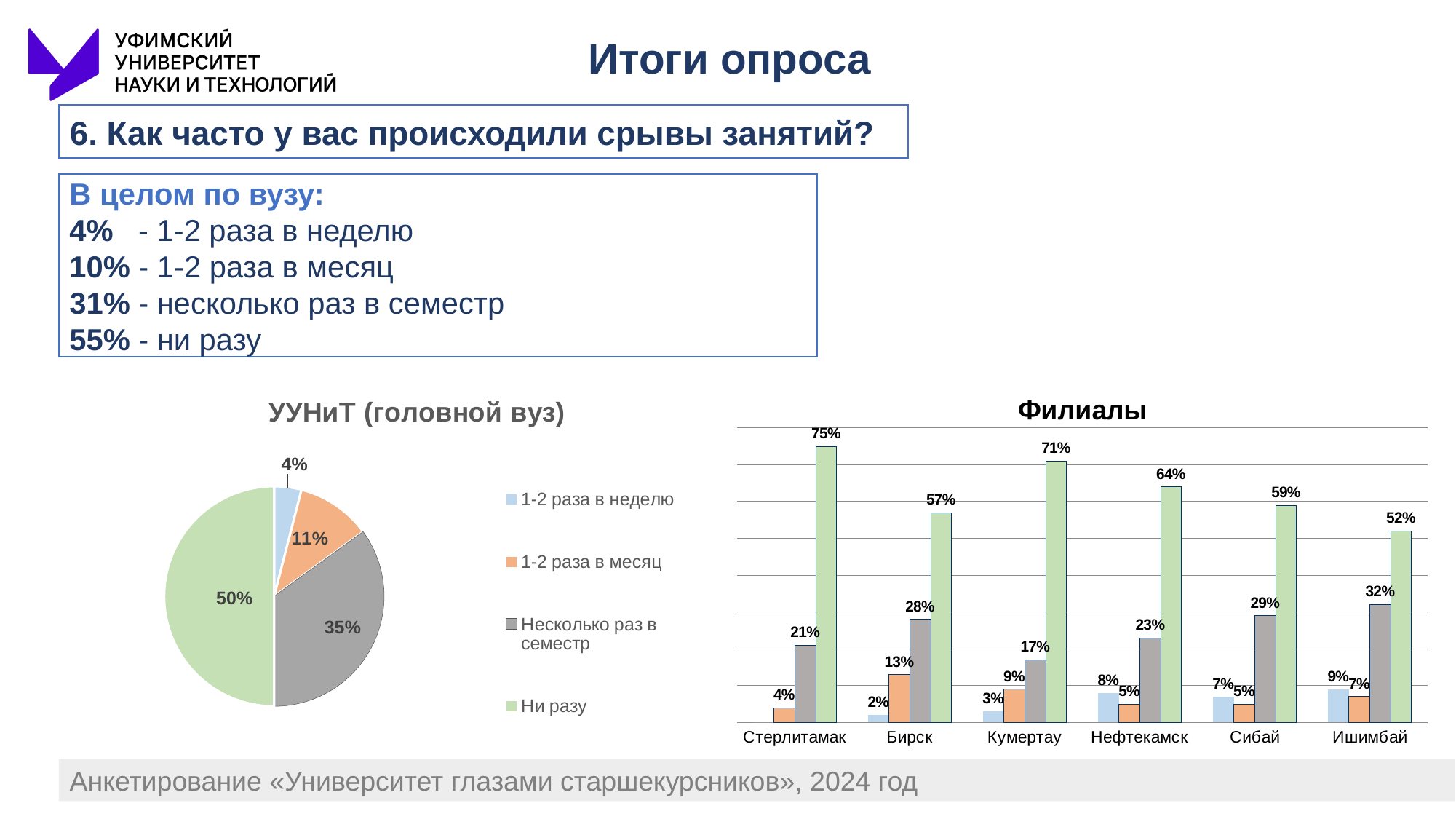
How many entries does the legend of the pie chart 'УУНиТ (головной вуз)' list? 4 On the 'Филиалы' chart, what is the value of the tallest (green) bar for Стерлитамак? 75% On the 'Филиалы' chart, what is the difference between the green bar values for Стерлитамак (75%) and Ишимбай (52%)? 23% On the pie chart 'УУНиТ (головной вуз)', what share is labelled for 'Ни разу'? 50% On the 'Филиалы' chart, which branch has the lowest green bar? Ишимбай On the pie chart 'УУНиТ (головной вуз)', what is the value for 'Несколько раз в семестр'? 35% On the 'Филиалы' chart, is the grey bar for Ишимбай (32%) larger or smaller than the grey bar for Бирск (28%)? larger On the 'Филиалы' chart, which branch has the highest green bar? Стерлитамак What kind of chart is the chart titled 'Филиалы'? bar chart On the 'Филиалы' chart, what is the value of the grey bar for Нефтекамск? 23% On the 'Филиалы' chart, how many branch categories are shown on the x axis? 6 On the pie chart 'УУНиТ (головной вуз)', which category has the smallest slice? 1-2 раза в неделю